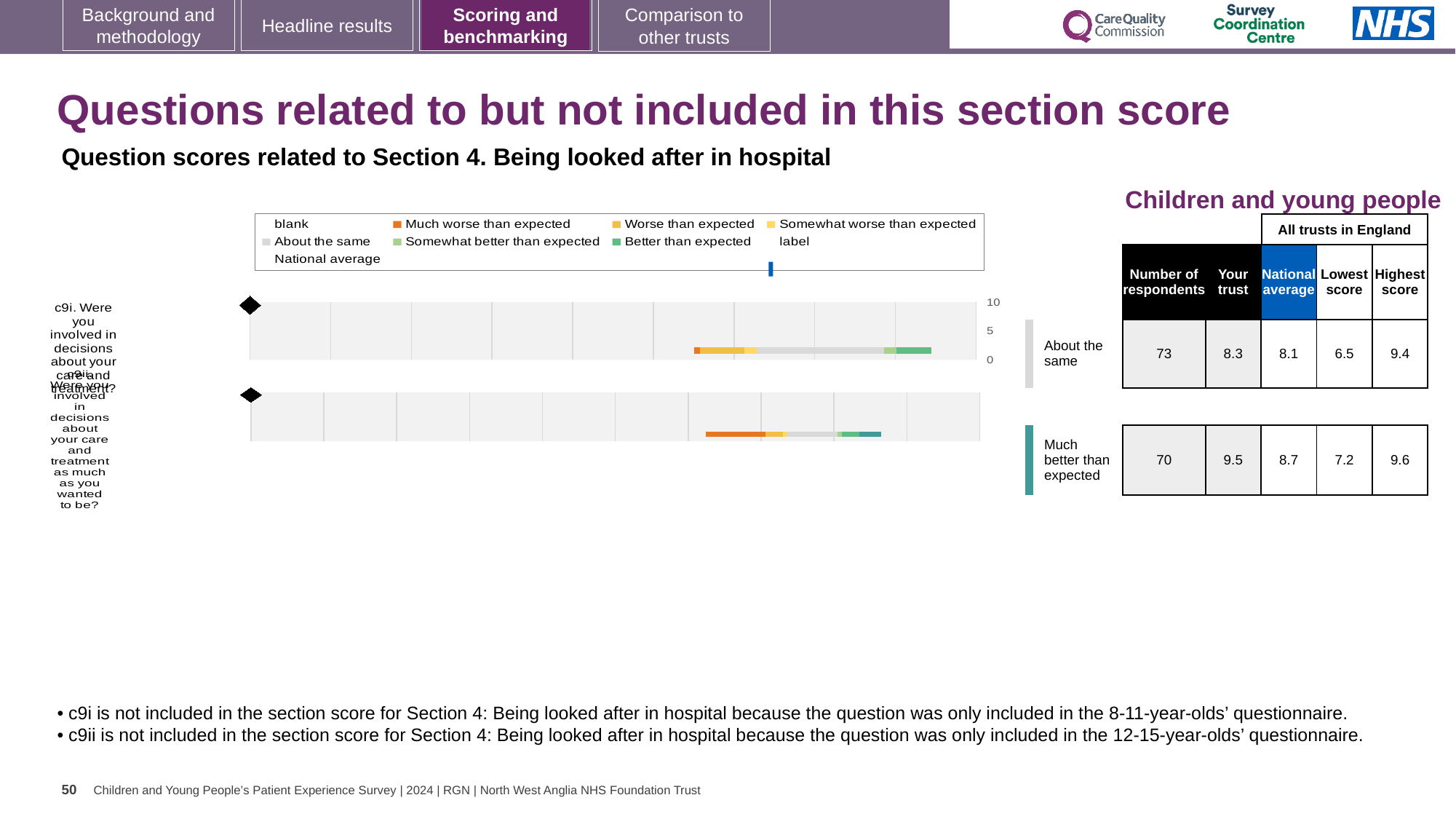
What kind of chart is shown on the slide? bar chart What is the national average score for c9ii? 8.7 How many question bars are plotted in the chart? 2 What is the 'Your trust' score for c9ii? 9.5 How many entries does the chart legend list? 9 What is the highest score across all trusts in England for c9i? 9.4 What benchmark category is shown next to the bar for c9i? About the same What is the 'Your trust' score for c9i? 8.3 What is the difference between the 'Your trust' scores for c9ii and c9i? 1.2 Which question has the higher 'Your trust' score, c9i or c9ii? c9ii How many respondents answered c9i? 73 Which legend entry is shown with a dark orange colour? Much worse than expected